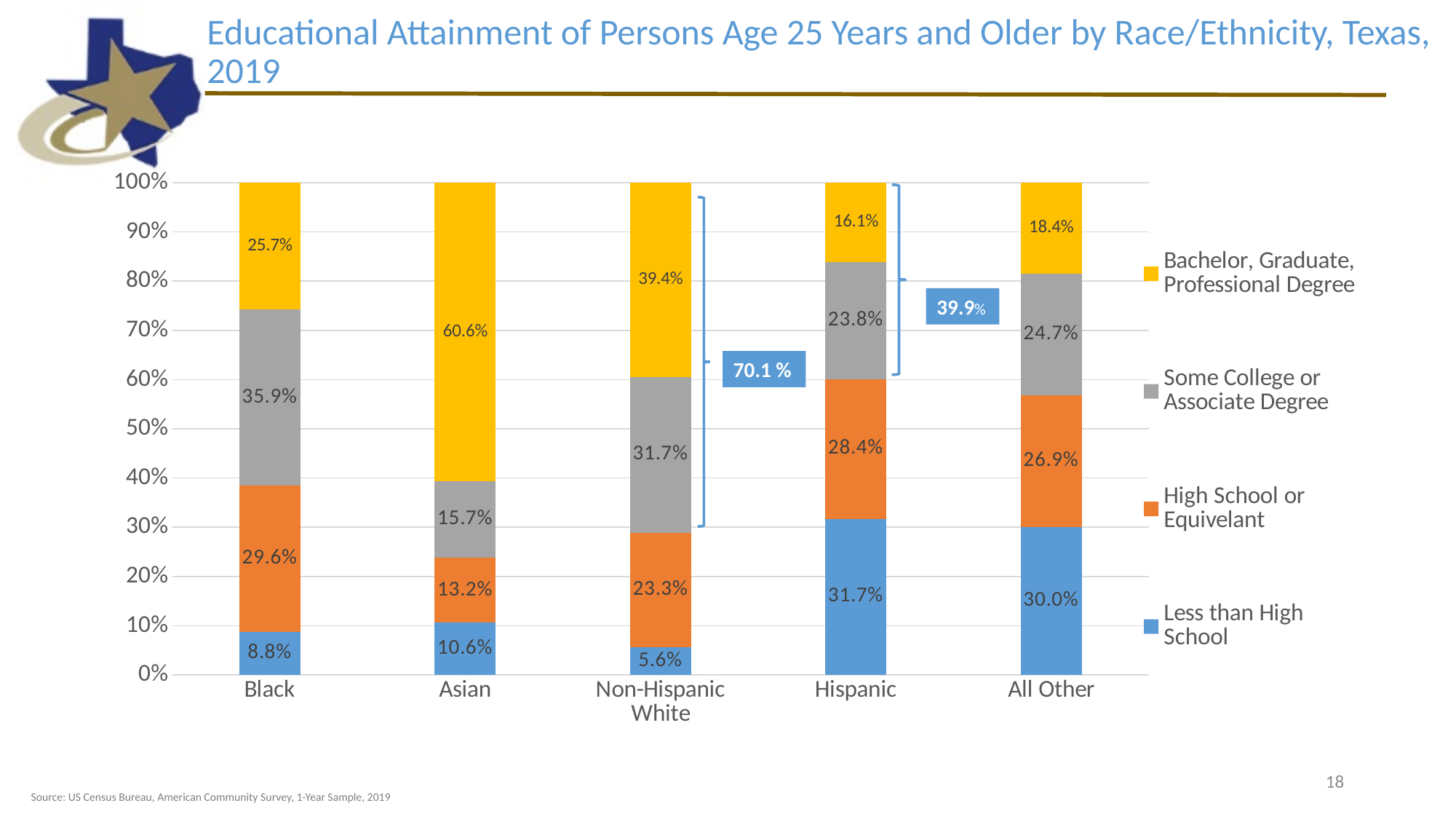
Which race/ethnicity group has the highest share with a Bachelor, Graduate, or Professional Degree? Asian Which group has a larger High School or Equivalent share, Black or Hispanic? Black Which race/ethnicity group has the highest Less than High School share? Hispanic How many education categories does the legend list? 4 How many percentage points higher is the Bachelor, Graduate, Professional Degree share for Asian than for Black? 34.9 percentage points How many race/ethnicity groups are shown on the x axis? 5 What type of chart is shown on the slide? Stacked bar chart What percentage of Asians age 25 and older have a Bachelor, Graduate, or Professional Degree? 60.6% What is the Some College or Associate Degree share for the All Other group? 24.7% What is the Less than High School share for Hispanic persons? 31.7% Which education category is shown in blue in the legend? Less than High School Which race/ethnicity group has the lowest Less than High School share? Non-Hispanic White